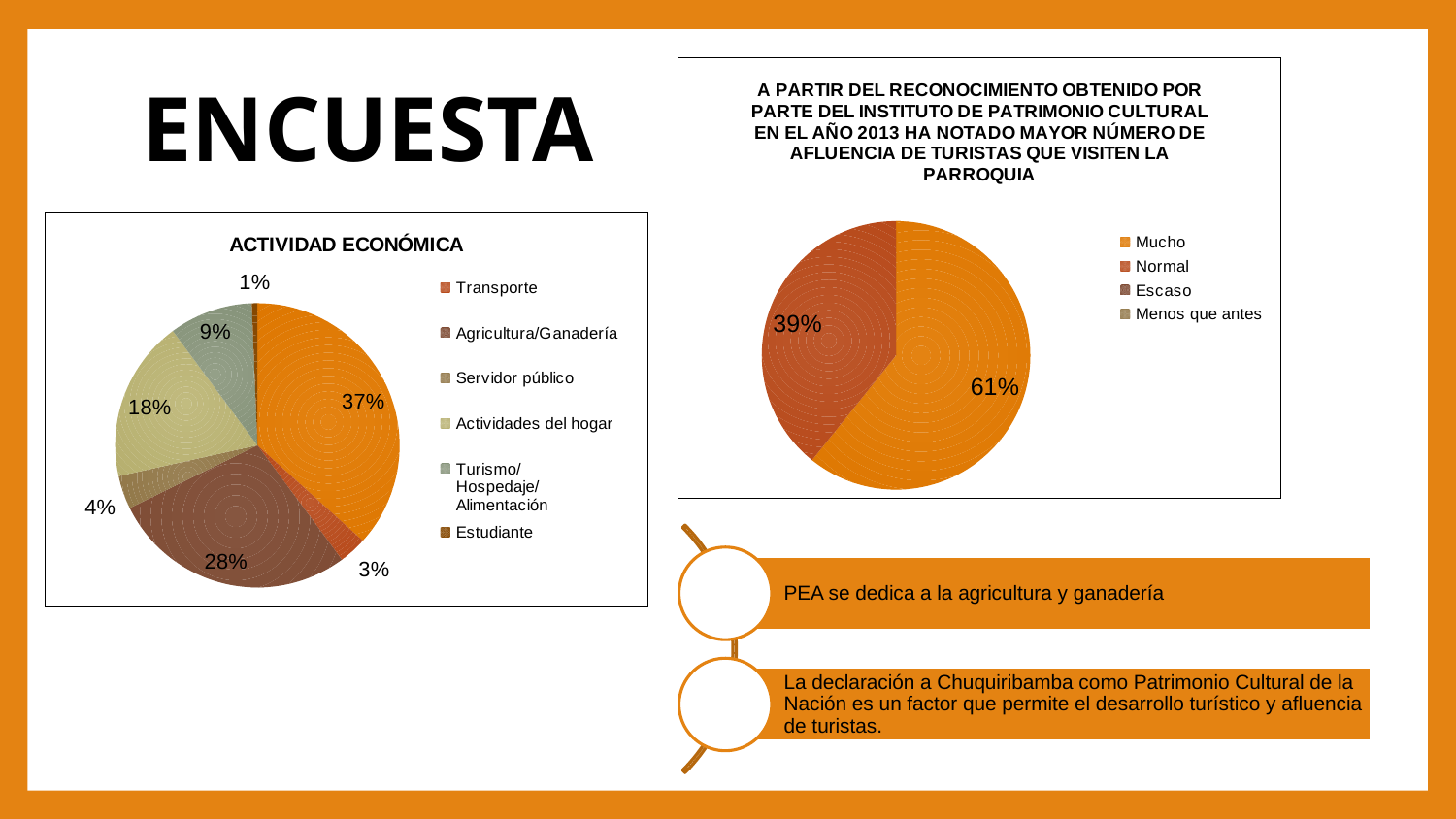
In the chart on the right about the afluencia de turistas, what share does 'Normal' have? 39% In the 'ACTIVIDAD ECONÓMICA' chart, what is the difference between the 37% slice and the 28% slice? 9% How many entries does the legend of the 'ACTIVIDAD ECONÓMICA' chart list? 6 In the chart on the right, which is larger, 'Mucho' or 'Normal'? Mucho What kind of chart is the 'ACTIVIDAD ECONÓMICA' chart? pie chart How many entries does the legend of the chart on the right list? 4 What is the title of the chart on the left? ACTIVIDAD ECONÓMICA In the chart on the right about the afluencia de turistas, what share does 'Mucho' have? 61% In the 'ACTIVIDAD ECONÓMICA' chart, what is the share of the smallest slice? 1% In the 'ACTIVIDAD ECONÓMICA' chart, what is the share of the largest slice? 37% In the chart on the right, what is the difference between the 'Mucho' and 'Normal' shares? 22%